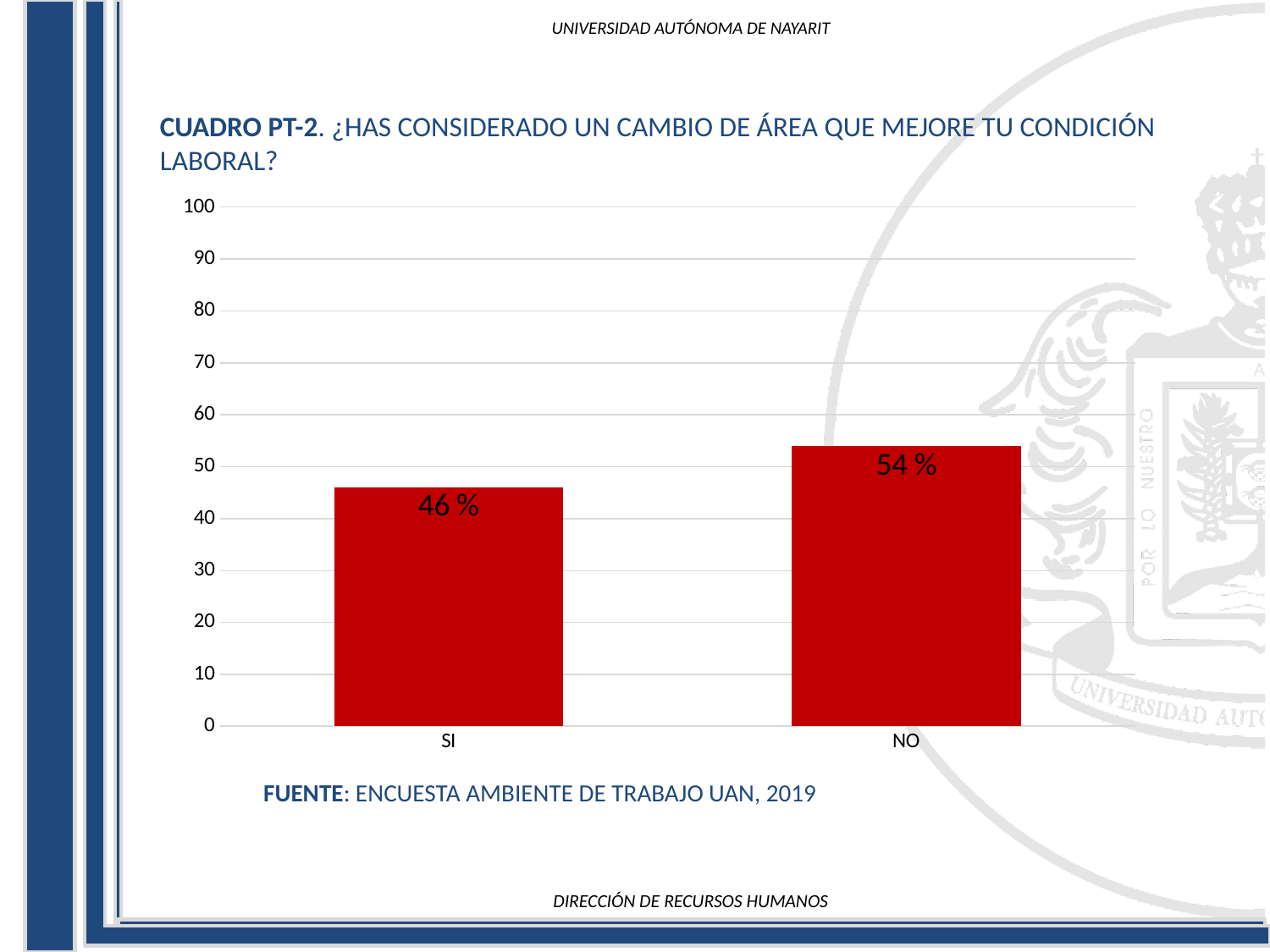
What is the total of the values for SI and NO? 100 % What colour are the bars in the chart? red Which is larger, the value for SI or the value for NO? NO Is the value for NO greater or less than 50? greater What is the difference between the values for NO and SI? 8 % What is the value for SI? 46 % What is the value for NO? 54 % Is the value for SI greater or less than 50? less Which category has the highest value? NO How many categories are shown on the x axis? 2 Which category has the lowest value? SI What kind of chart is shown on the slide? bar chart